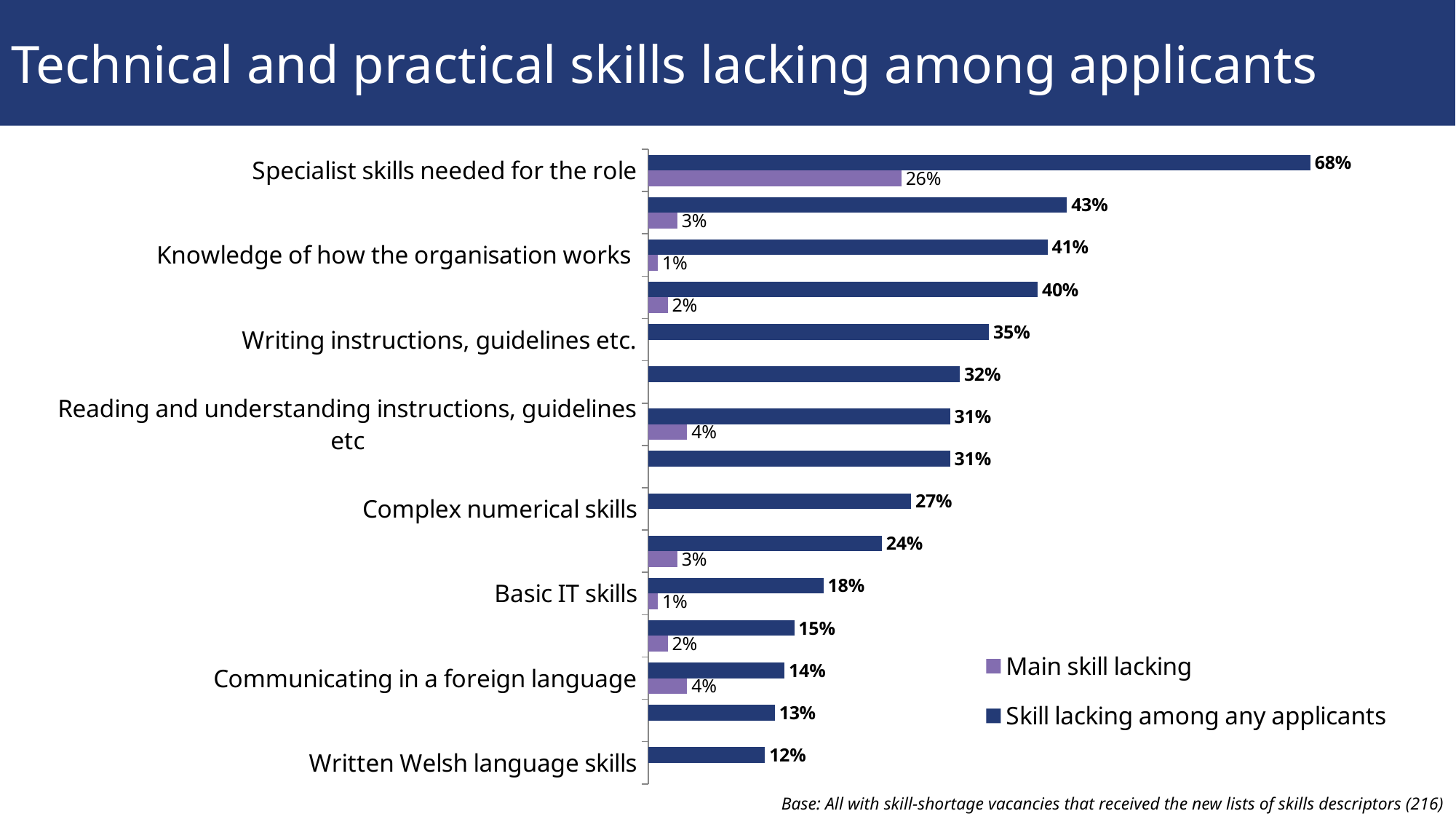
Which has a higher 'Skill lacking among any applicants' value: writing instructions, guidelines etc. or complex numerical skills? Writing instructions, guidelines etc. Which category has the highest 'Skill lacking among any applicants' value? Specialist skills needed for the role Which labelled category has the lowest 'Skill lacking among any applicants' value? Written Welsh language skills How many series does the legend list? 2 What is the 'Skill lacking among any applicants' value for knowledge of how the organisation works? 41% What is the value for 'Main skill lacking' for specialist skills needed for the role? 26% What is the 'Main skill lacking' value for communicating in a foreign language? 4% What percentage of employers reported specialist skills needed for the role as a skill lacking among any applicants? 68% What is the difference between the 'Skill lacking among any applicants' and 'Main skill lacking' values for specialist skills needed for the role? 42% What is the 'Skill lacking among any applicants' value for basic IT skills? 18% What type of chart is shown on the slide? Bar chart Which series is shown in purple according to the legend? Main skill lacking